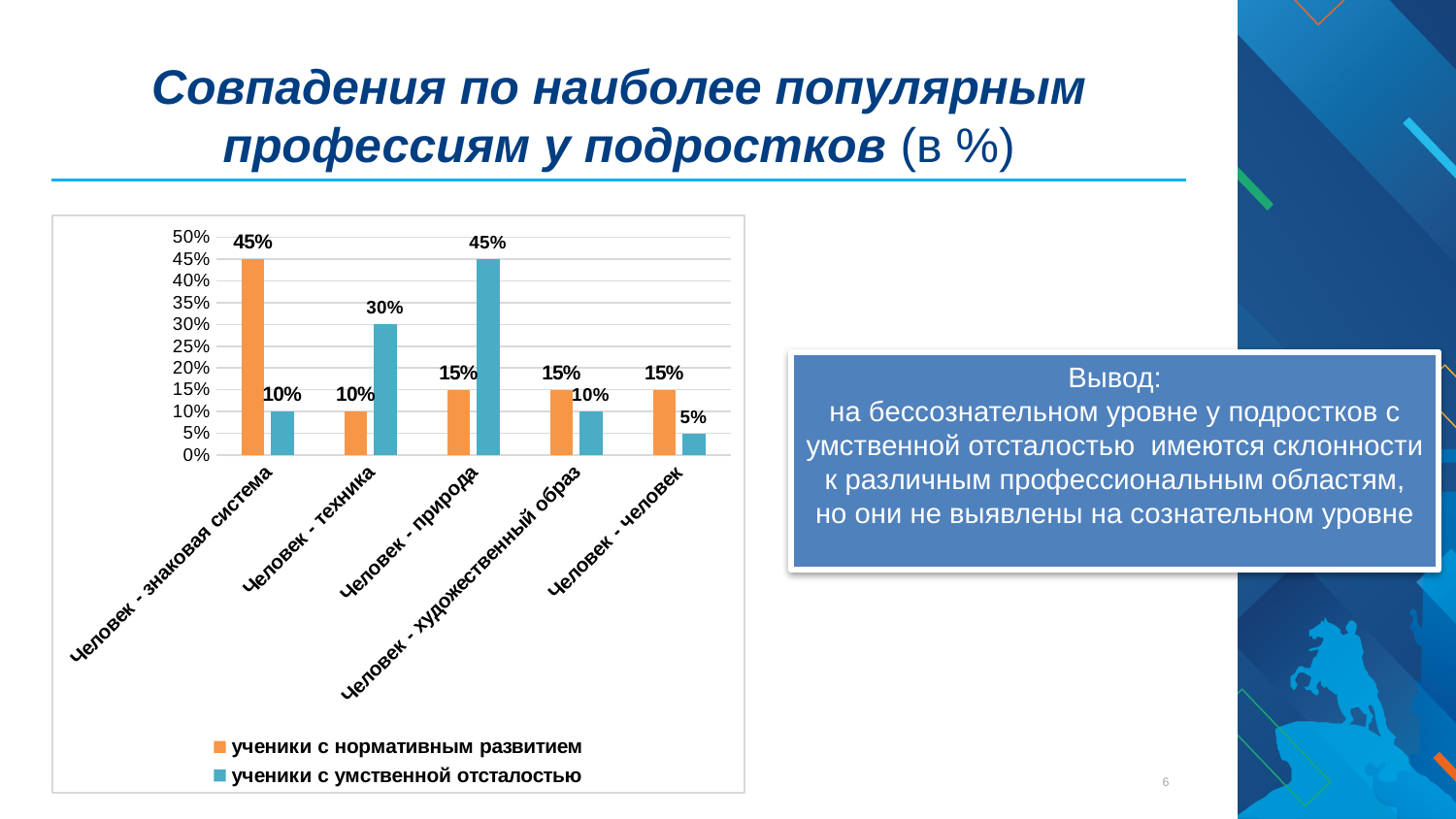
Which category has the lowest value for "ученики с нормативным развитием"? Человек - техника What is the value for "ученики с умственной отсталостью" in the category "Человек - техника"? 30% What is the value for "ученики с умственной отсталостью" in the category "Человек - человек"? 5% What is the difference between the two series in the category "Человек - природа"? 30% Which colour represents "ученики с умственной отсталостью" in the chart? blue How many categories are shown on the x axis? 5 In the category "Человек - художественный образ", which series has the larger value? ученики с нормативным развитием Is the value for "ученики с умственной отсталостью" in "Человек - знаковая система" greater or less than 20%? less What is the value for "ученики с нормативным развитием" in the category "Человек - знаковая система"? 45% What kind of chart is shown on the slide? bar chart Which category has the highest value for "ученики с умственной отсталостью"? Человек - природа How many series does the legend list? 2